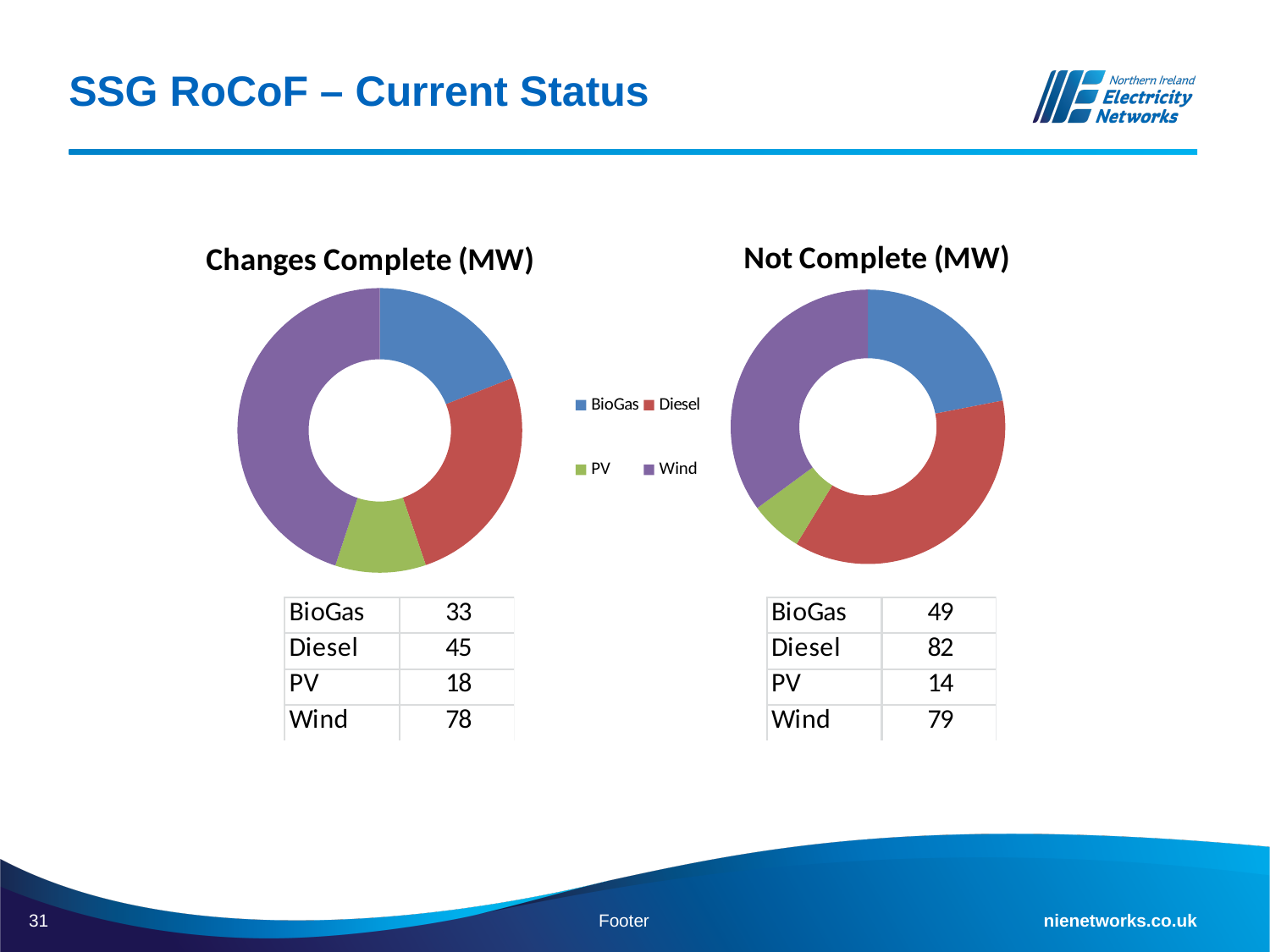
Which is larger: BioGas in the Changes Complete (MW) chart or BioGas in the Not Complete (MW) chart? Not Complete (MW) What is the total of all categories in the Changes Complete (MW) chart? 174 In the Changes Complete (MW) chart, what is the value for PV? 18 In the Changes Complete (MW) chart, what is the difference between Wind and Diesel? 33 In the Changes Complete (MW) chart, which category has the lowest value? PV Which colour represents Wind in the legend between the two charts? Purple What kind of chart is the Changes Complete (MW) chart? Doughnut chart In the Not Complete (MW) chart, what is the difference between Diesel and BioGas? 33 In the Not Complete (MW) chart, which category has the highest value? Diesel In the Changes Complete (MW) chart, what is the value for Wind? 78 How many categories does the Not Complete (MW) chart show? 4 In the Not Complete (MW) chart, what is the value for Diesel? 82